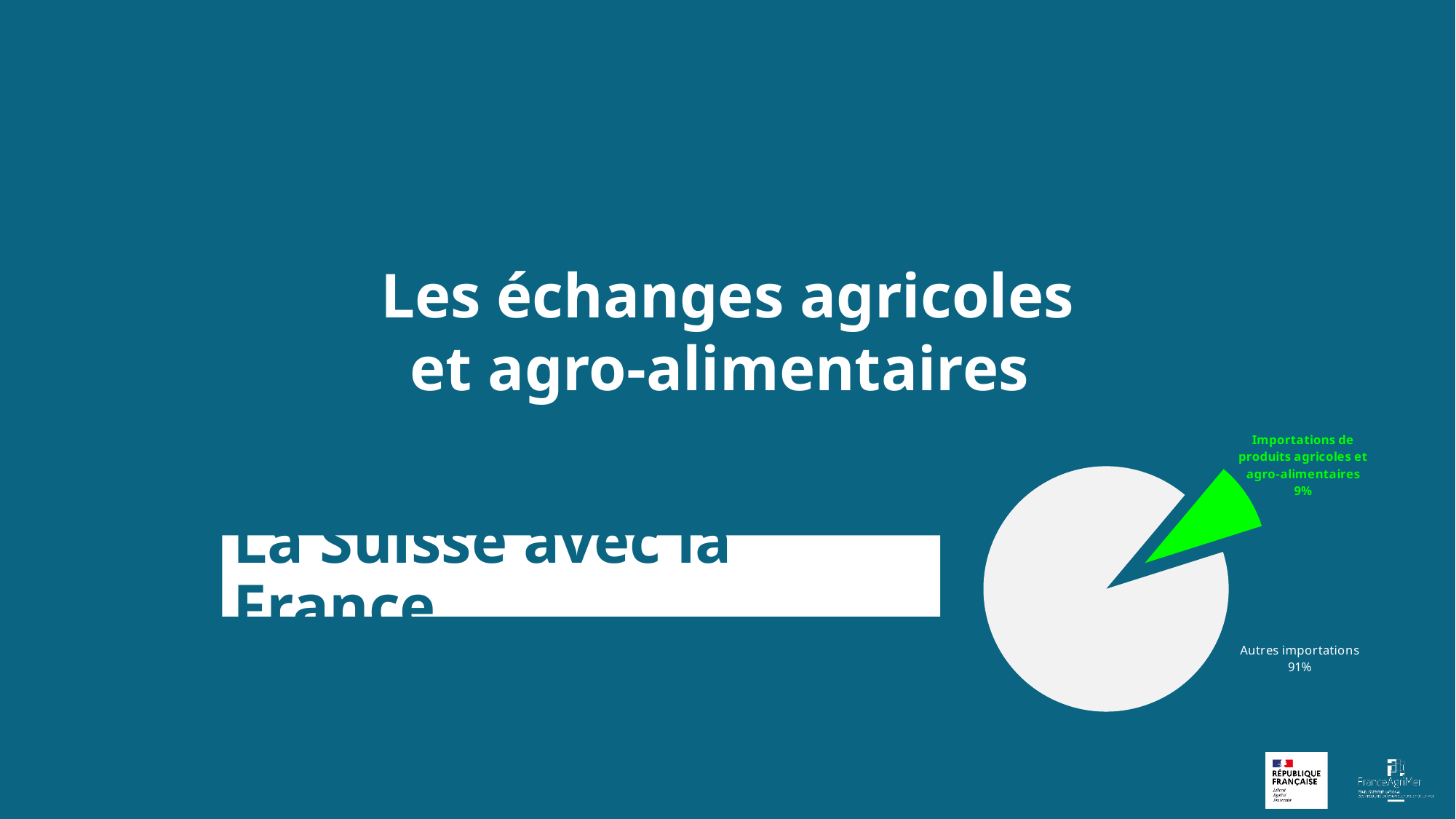
What is the difference in percentage points between "Autres importations" and "Importations de produits agricoles et agro-alimentaires"? 82 What kind of chart is shown on the slide? pie chart Which slice of the pie is the smallest? Importations de produits agricoles et agro-alimentaires What share of the pie is labelled "Importations de produits agricoles et agro-alimentaires"? 9% What is the total of the two slice percentages shown on the pie chart? 100% Is the share for "Importations de produits agricoles et agro-alimentaires" greater or less than 10%? less What colour is the slice for "Importations de produits agricoles et agro-alimentaires"? green What share of the pie is labelled "Autres importations"? 91% Which is larger: the share for "Autres importations" or the share for "Importations de produits agricoles et agro-alimentaires"? Autres importations How many slices does the pie chart have? 2 Which slice of the pie is the largest? Autres importations